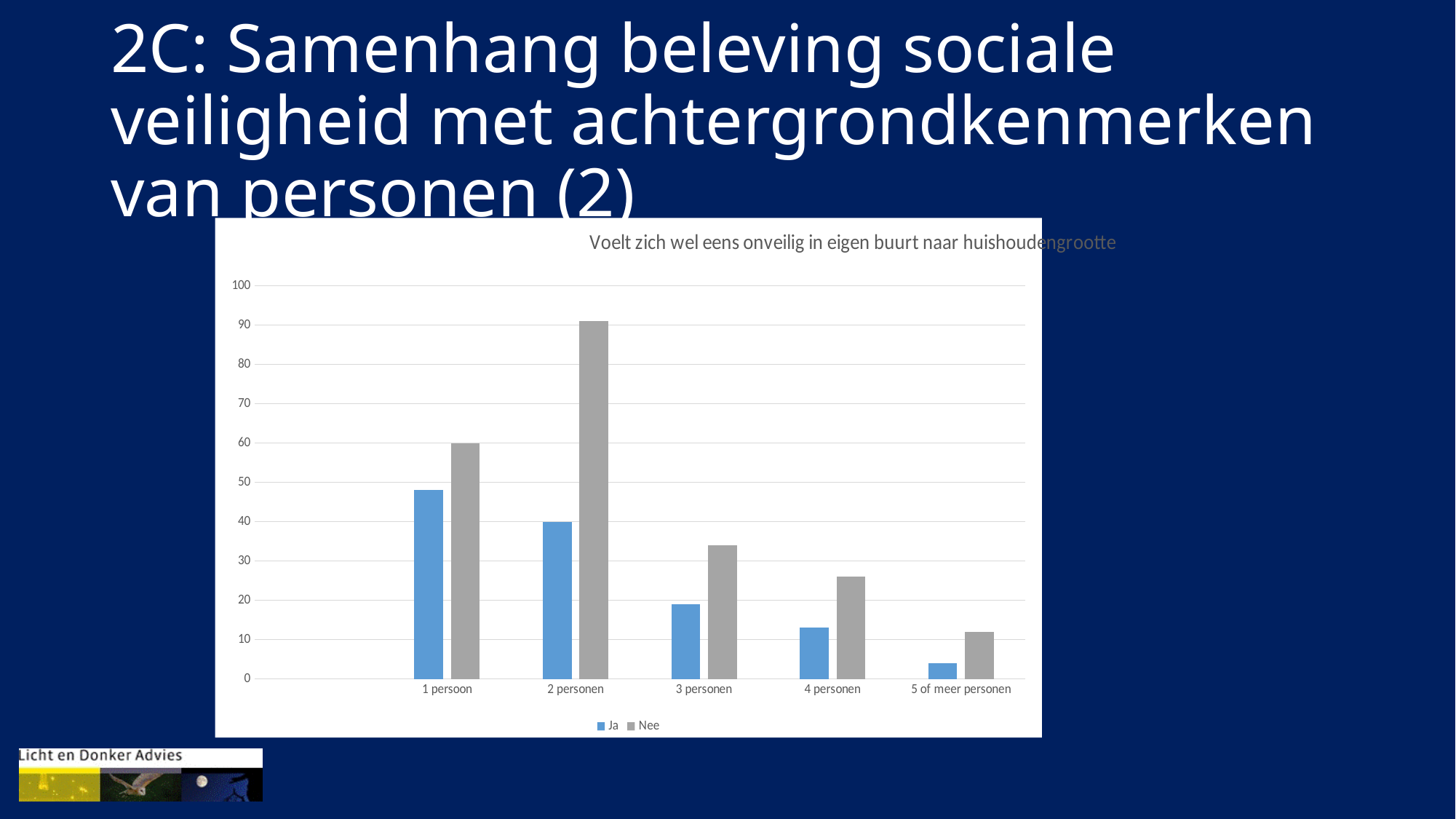
What kind of chart is shown on the slide? bar chart Which category has the highest Ja value? 1 persoon How many series does the legend list? 2 What is the title of the chart? Voelt zich wel eens onveilig in eigen buurt naar huishoudengrootte What are the two series named in the legend? Ja and Nee Which category has the highest Nee value? 2 personen How many household-size categories are shown on the x axis? 5 Which category has the lowest Ja value? 5 of meer personen For 4 personen, which is larger, the Ja value or the Nee value? Nee Do the Ja values rise or fall from 1 persoon to 5 of meer personen? fall